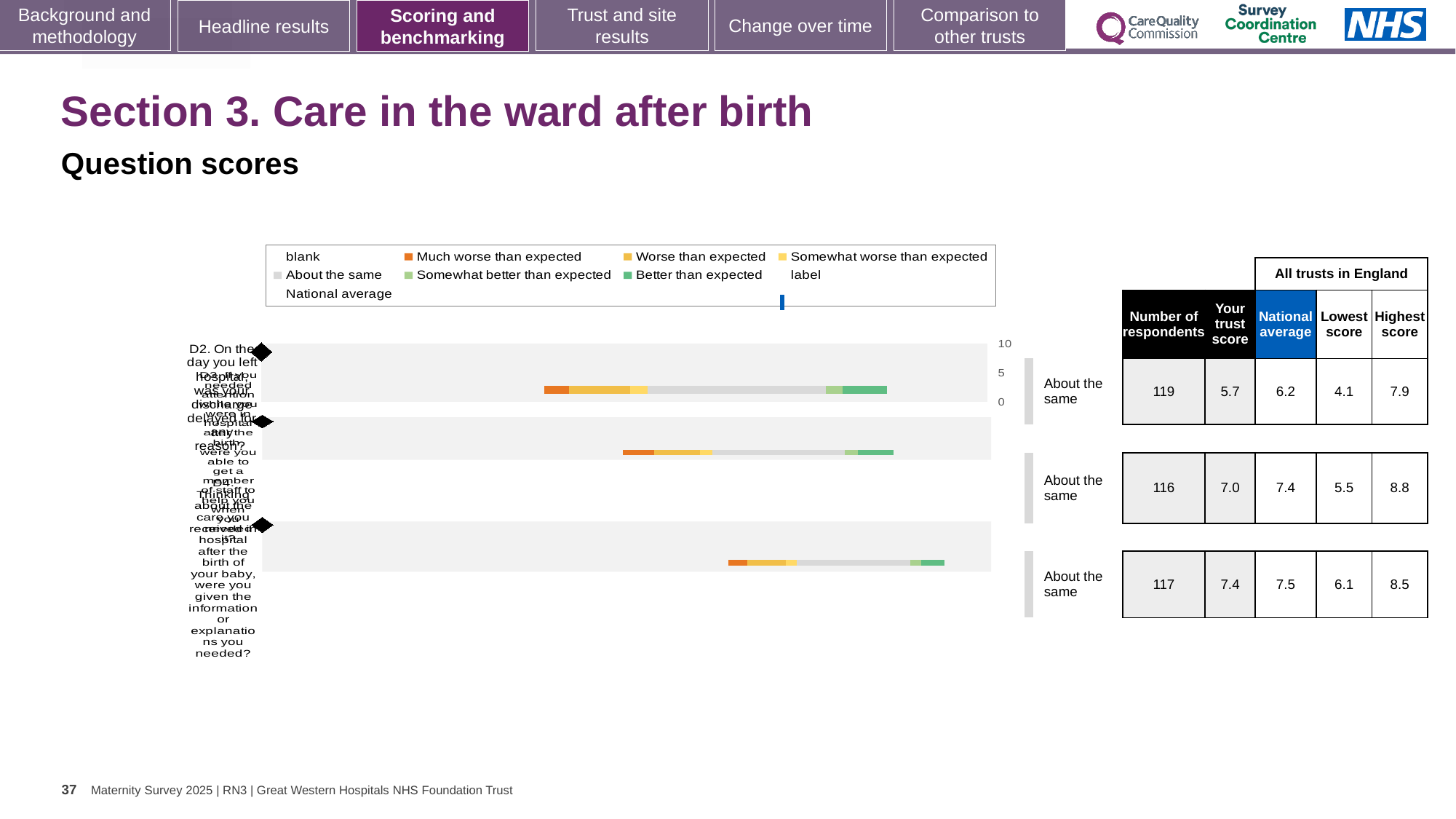
In the chart legend, what colour represents 'Much worse than expected'? orange What benchmark category is shown for all three questions in the chart? About the same For the first question row, which is larger: the trust score or the national average? national average What kind of chart is shown on the slide? bar chart For the first question row, what is the difference between the national average and the trust score? 0.5 In the table beside the chart, which question row has the lowest 'Lowest score' value? the first row (4.1) In the table beside the chart, what is the number of respondents for the third question row? 117 What is the highest value shown on the chart's score axis? 10 How many question bars are plotted in the chart? 3 In the table beside the chart, which question row has the highest 'Highest score' value? the second row (8.8) In the table beside the chart, what is the national average for the second question row? 7.4 In the table beside the chart, what is the 'Your trust score' for the first question row? 5.7